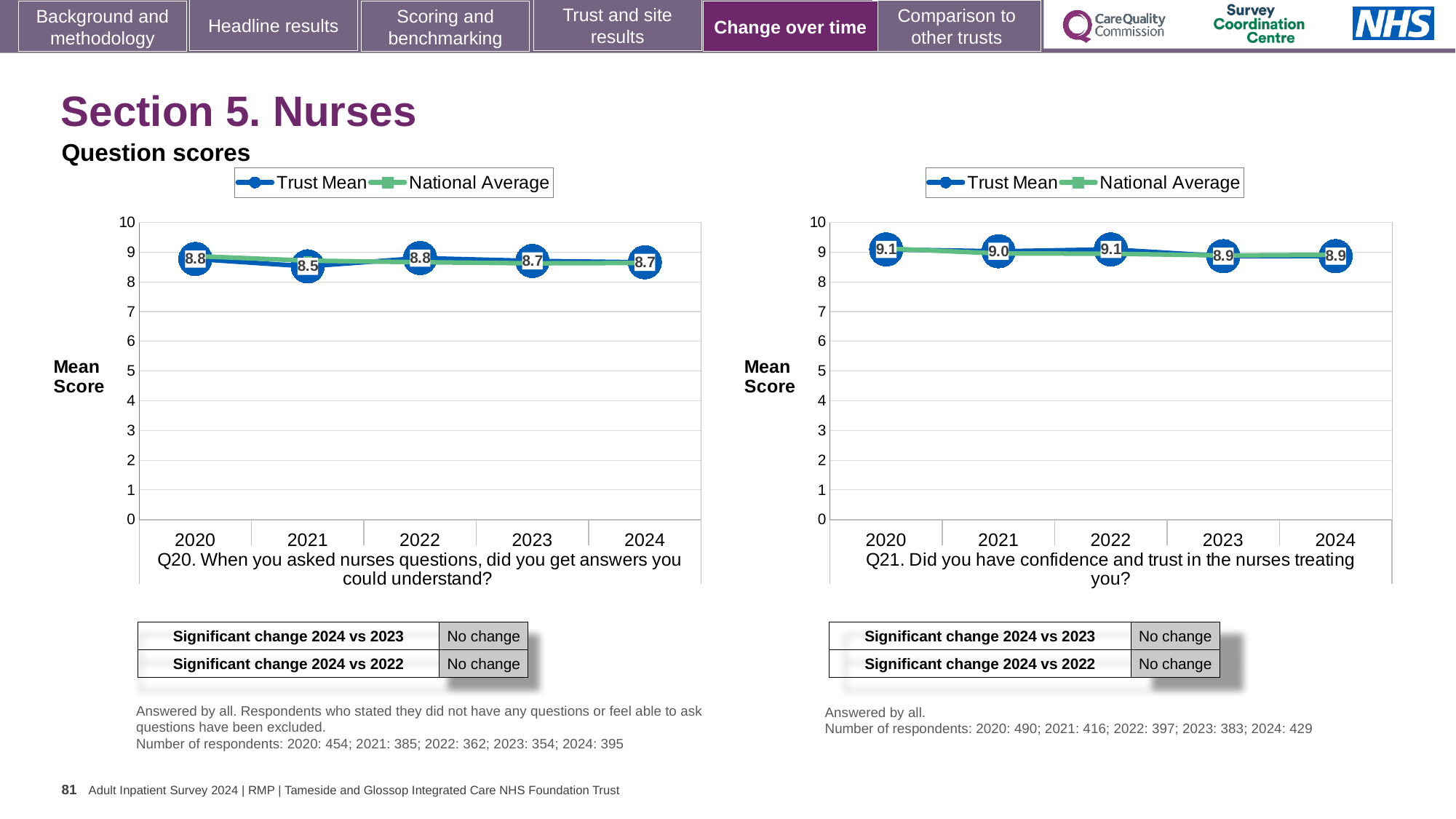
How many series does the legend of the Q20 chart list? 2 What kind of chart is the Q21 chart? line chart In the Q20 chart, what is the Trust Mean score for 2021? 8.5 In the Q20 chart, which year has the lowest Trust Mean score? 2021 In the Q20 chart, what is the difference between the Trust Mean scores for 2020 and 2021? 0.3 In the Q21 chart, what is the difference between the Trust Mean scores for 2022 and 2024? 0.2 How many years are plotted on the x axis of the Q21 chart? 5 In the Q21 chart, is the Trust Mean score for 2021 larger or smaller than the score for 2022? smaller In the Q20 chart, is the National Average value for 2024 greater or less than 8? greater In the Q21 chart, what is the Trust Mean score for 2020? 9.1 In the Q20 chart, what is the Trust Mean score for 2024? 8.7 In the Q21 chart, what is the Trust Mean score for 2023? 8.9